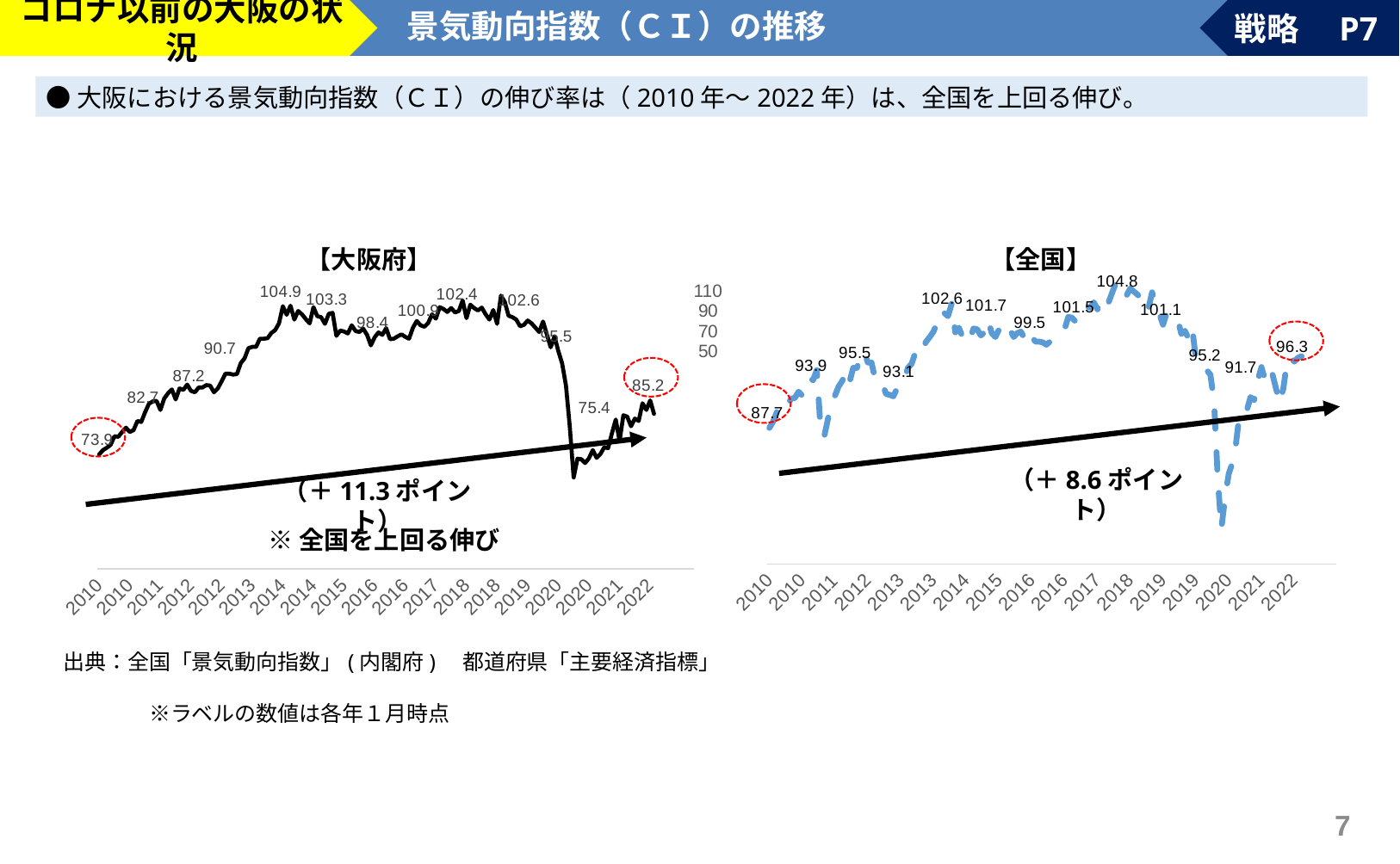
Which chart has the higher last labelled value, 【大阪府】 or 【全国】? 【全国】 In the 【大阪府】 chart, what is the highest labelled value? 104.9 In the 【全国】 chart, what is the lowest labelled value? 87.7 What kind of chart is the 【大阪府】 chart on the left? line chart In the 【全国】 chart, what is the difference between the last labelled value (96.3) and the first labelled value (87.7)? 8.6 In the 【大阪府】 chart, what is the lowest labelled value? 73.9 Which chart has the higher first labelled value, 【大阪府】 (73.9) or 【全国】 (87.7)? 【全国】 What is the title of the slide's main chart section shown in the blue header bar? 景気動向指数（ＣＩ）の推移 How many data labels are printed on the 【全国】 chart? 13 In the 【大阪府】 chart, what is the labelled value circled in red at the right end of the line? 85.2 In the 【大阪府】 chart, what is the difference between the last labelled value (85.2) and the first labelled value (73.9)? 11.3 In the 【全国】 chart, what is the highest labelled value? 104.8